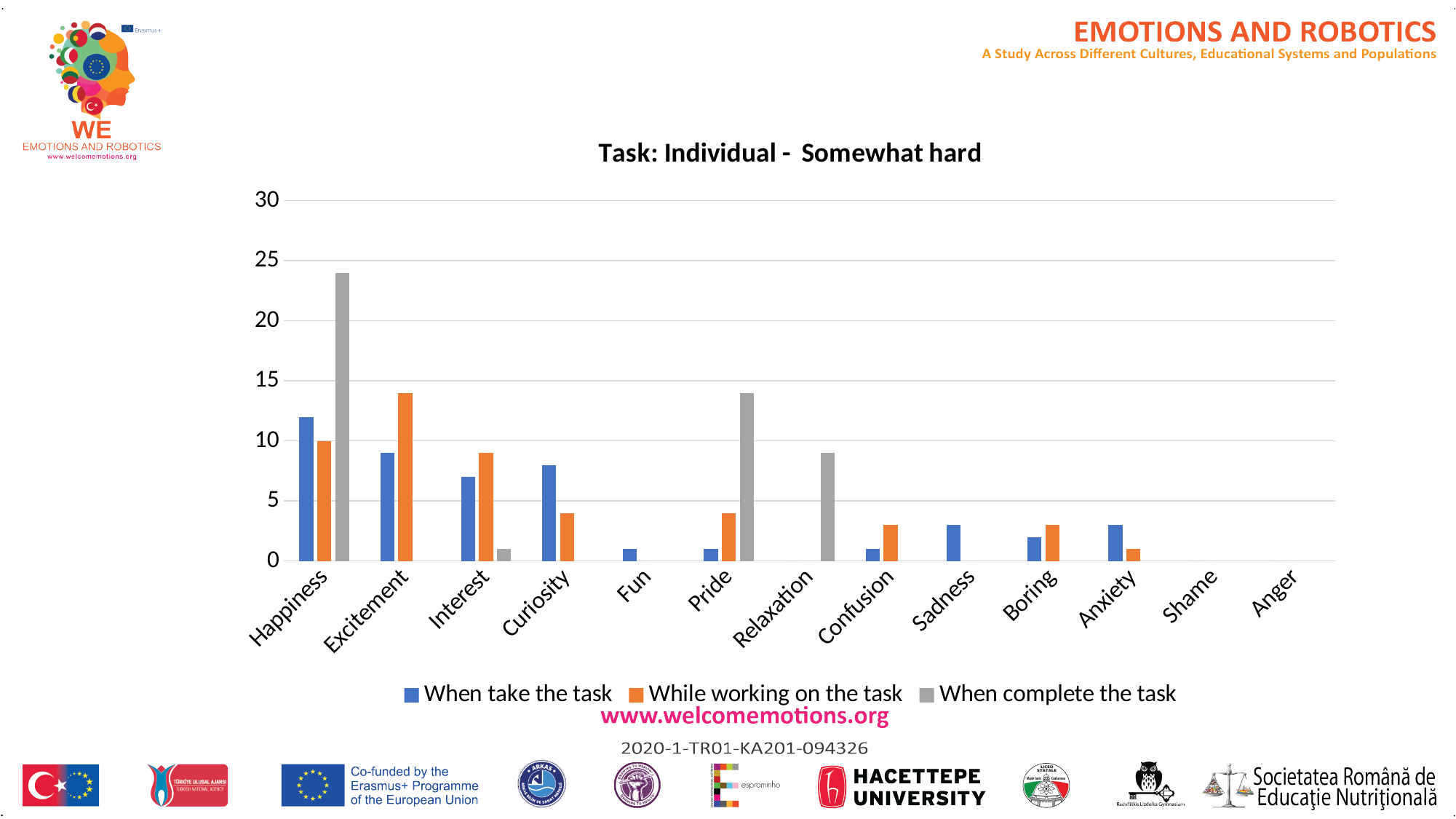
How many series does the legend list? 3 What is the title of the chart? Task: Individual - Somewhat hard Which emotion has the highest value for the 'When complete the task' series? Happiness Which emotion has the tallest bar in the chart? Happiness Which is larger: the 'When take the task' value for Happiness or for Excitement? Happiness Is the 'When complete the task' value for Happiness greater or less than 20? greater How many emotion categories are shown on the x axis? 13 Is the 'While working on the task' value for Excitement greater or less than 10? greater Is the 'When take the task' value for Curiosity greater or less than 10? less Which emotion has the highest value for the 'While working on the task' series? Excitement Which colour represents the 'When complete the task' series in the legend? grey What kind of chart is shown on the slide? bar chart